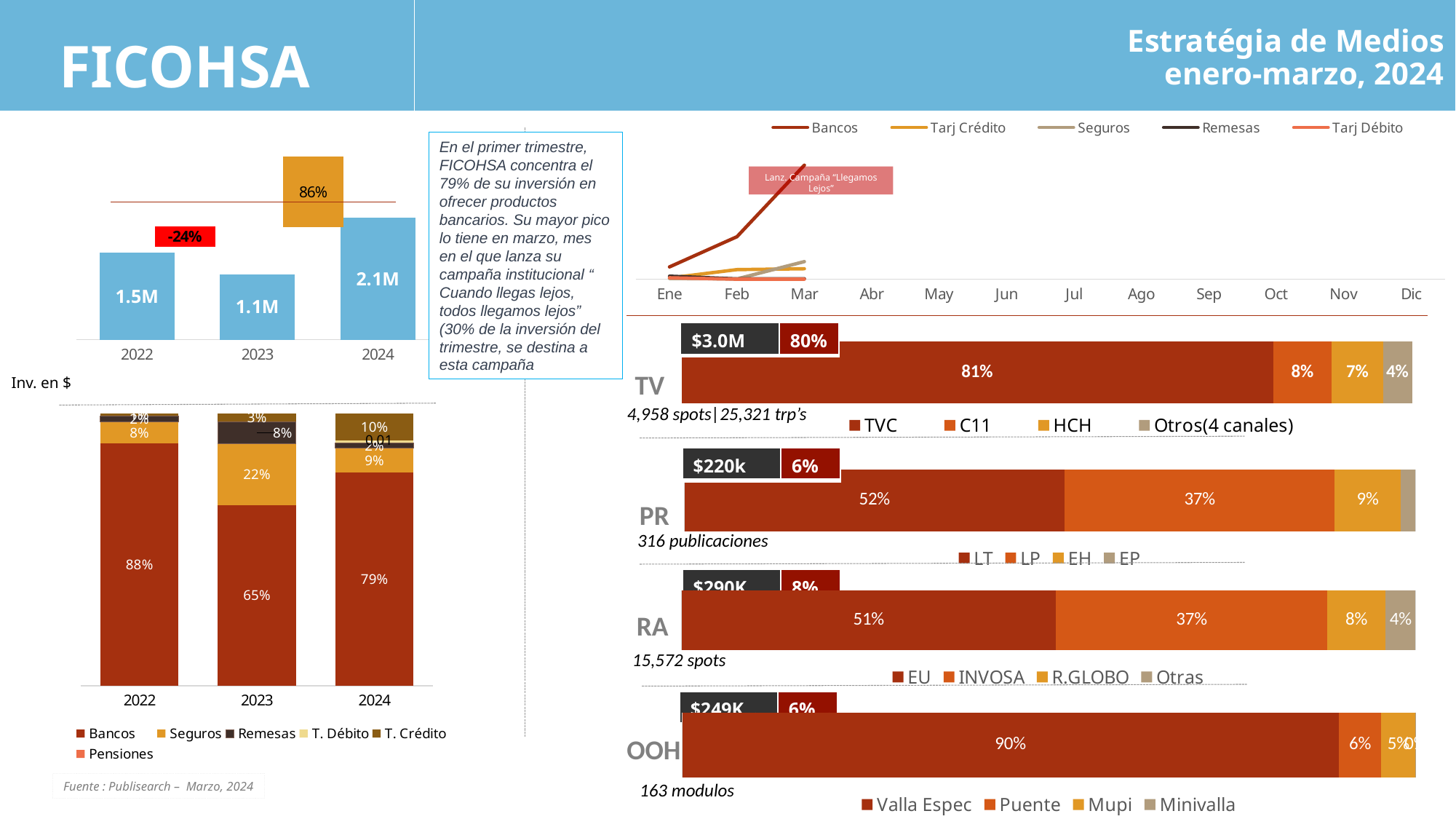
In the top-left bar chart of investment by year, what percentage change is shown for 2023? -24% In the bottom-left stacked bar chart by product, how many series does the legend list? 6 In the RA stacked bar on the right, what is the difference between the EU share and the INVOSA share? 14% In the top-left bar chart of investment by year, which year has the lowest investment? 2023 In the OOH stacked bar on the right, which segment is the largest? Valla Espec In the TV stacked bar on the right, what share does TVC have? 81% In the bottom-left stacked bar chart by product, what share does Bancos have in 2023? 65% In the top-right line chart, which series has the highest value in Mar? Bancos In the top-left bar chart of investment by year, what is the value for 2024? 2.1M In the top-left bar chart of investment by year, what kind of chart is it? bar chart In the bottom-left stacked bar chart by product, what share does Seguros have in 2023? 22% In the top-right line chart, how many series does the legend list? 5